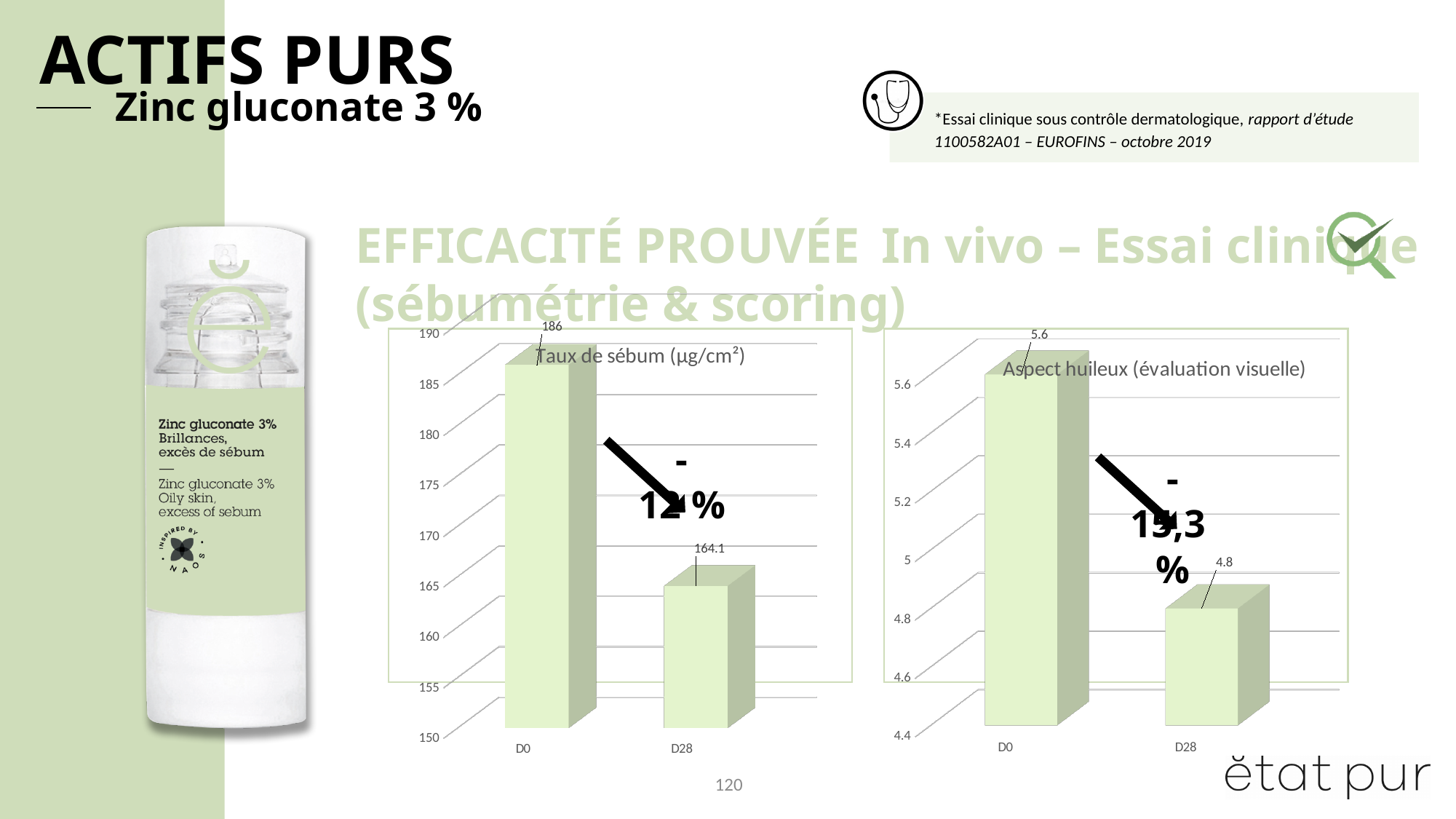
In the 'Aspect huileux (évaluation visuelle)' chart, what is the value at D28? 4.8 What kind of chart is the 'Aspect huileux (évaluation visuelle)' chart? bar chart In the 'Aspect huileux (évaluation visuelle)' chart, what is the difference between the D0 and D28 values? 0.8 In the 'Aspect huileux (évaluation visuelle)' chart, what is the value at D0? 5.6 In the 'Aspect huileux (évaluation visuelle)' chart, do the values rise or fall from D0 to D28? fall In the 'Taux de sébum (µg/cm²)' chart, is the value at D28 greater or less than 170? less In the 'Taux de sébum (µg/cm²)' chart, what is the value at D0? 186 How many time points are plotted in the 'Taux de sébum (µg/cm²)' chart? 2 In the 'Aspect huileux (évaluation visuelle)' chart, which time point has the lowest value? D28 In the 'Taux de sébum (µg/cm²)' chart, what is the value at D28? 164.1 In the 'Taux de sébum (µg/cm²)' chart, what is the difference between the D0 and D28 values? 21.9 In the 'Taux de sébum (µg/cm²)' chart, which time point has the highest value? D0